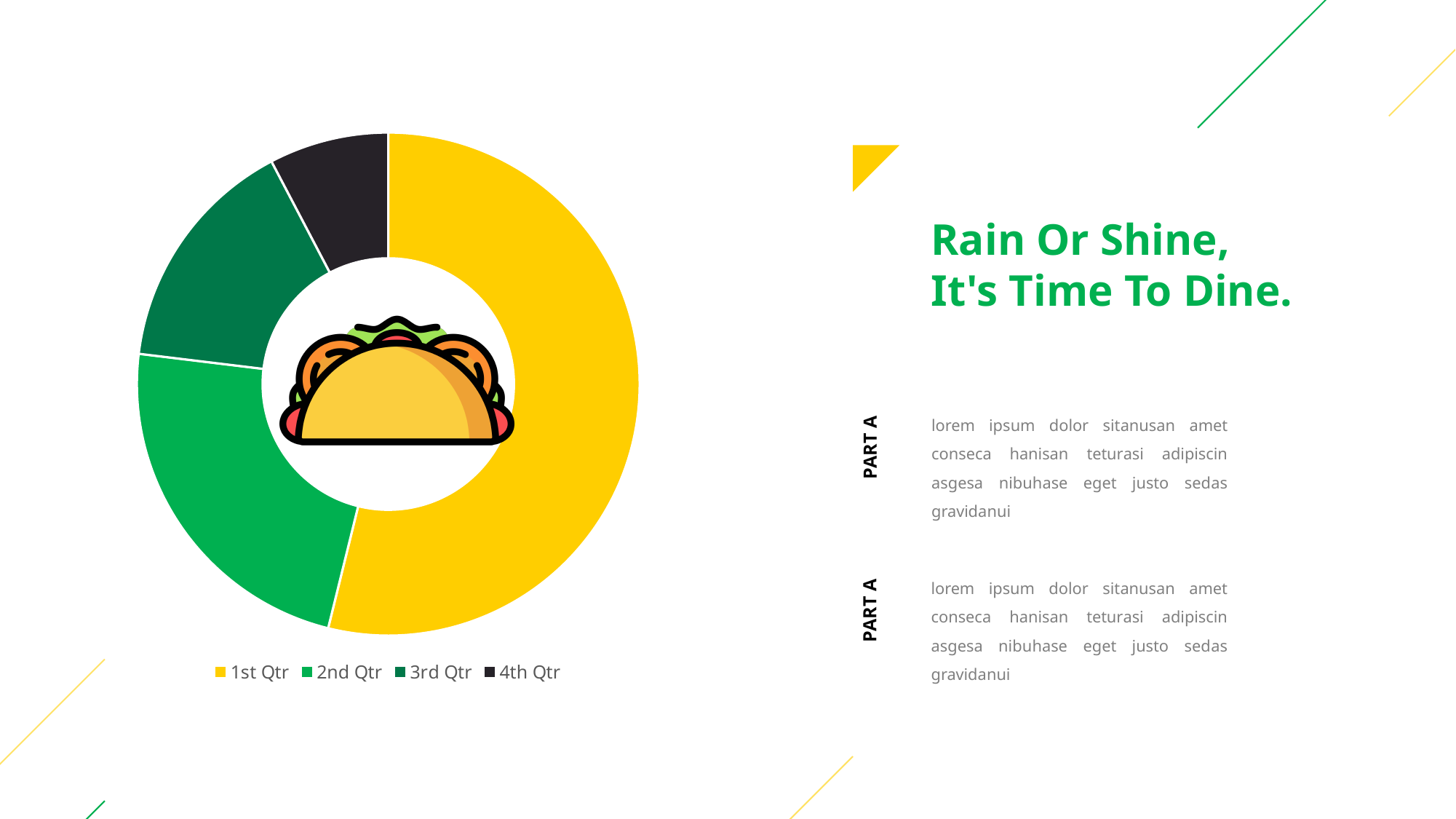
What kind of chart is shown on the slide? Doughnut chart Which slice is larger, 2nd Qtr or 3rd Qtr? 2nd Qtr Which category is shown in black in the doughnut chart? 4th Qtr Which category has the smallest slice in the doughnut chart? 4th Qtr Which slice is larger, 1st Qtr or 2nd Qtr? 1st Qtr What colour is the 1st Qtr slice in the doughnut chart? Yellow How many entries does the chart legend list? 4 How many categories does the doughnut chart show? 4 Which slice is larger, 3rd Qtr or 4th Qtr? 3rd Qtr Which category has the largest slice in the doughnut chart? 1st Qtr